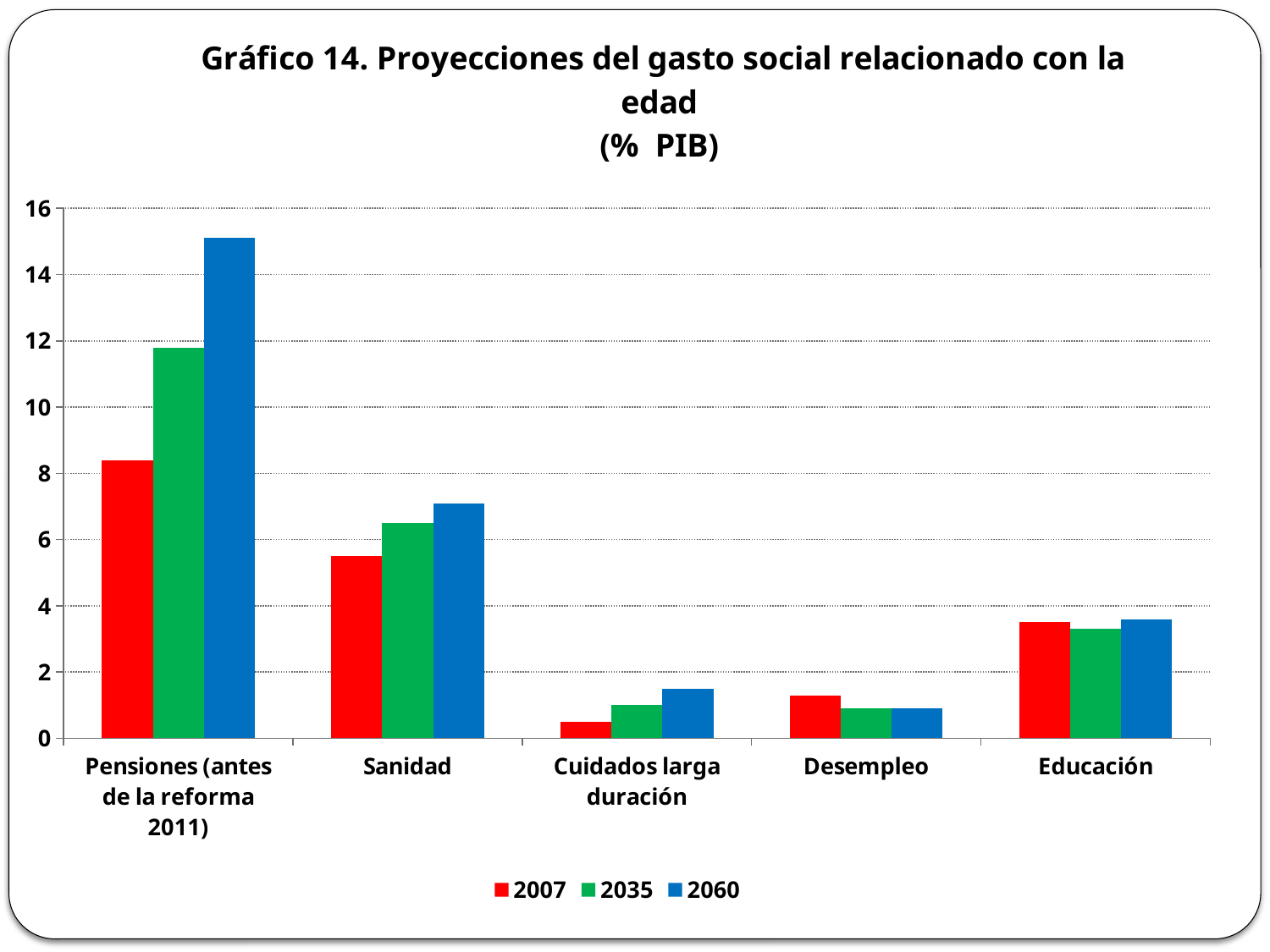
Is the 2007 value for Sanidad greater or less than 6? less For Desempleo, which series has the larger value, 2007 or 2035? 2007 Is the 2035 value for Educación greater or less than 4? less Which colour represents the 2035 series in the legend? green What kind of chart is shown on the slide? bar chart Which category has the lowest value for the 2007 series? Cuidados larga duración Which category has the highest value for the 2060 series? Pensiones (antes de la reforma 2011) Do the values for Cuidados larga duración rise or fall from 2007 to 2060? rise How many categories are shown on the x axis? 5 For Sanidad, which series has the larger value, 2007 or 2060? 2060 Is the 2060 value for Pensiones (antes de la reforma 2011) greater or less than 14? greater How many series does the legend list? 3